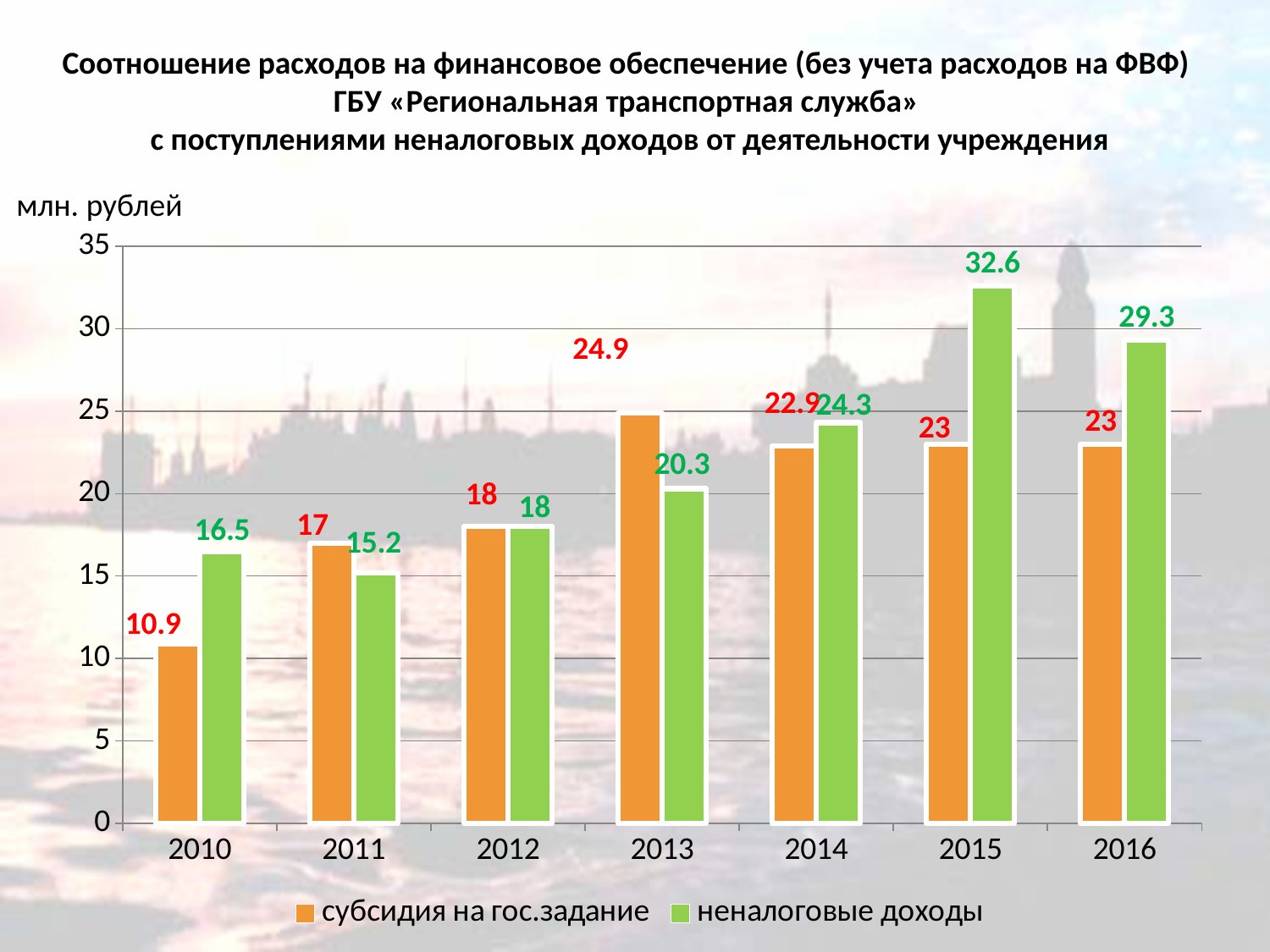
What is the value of неналоговые доходы in 2013? 20.3 What unit is indicated above the chart's vertical axis? млн. рублей How many years are shown on the x axis? 7 In which year is неналоговые доходы highest? 2015 Is the value of неналоговые доходы in 2016 greater or less than 25? greater What is the value of субсидия на гос.задание in 2010? 10.9 What kind of chart is shown on the slide? bar chart What is the value of неналоговые доходы in 2015? 32.6 In which year is субсидия на гос.задание lowest? 2010 How many series does the legend list? 2 What is the difference between неналоговые доходы and субсидия на гос.задание in 2015? 9.6 In 2013, which is larger: субсидия на гос.задание or неналоговые доходы? субсидия на гос.задание